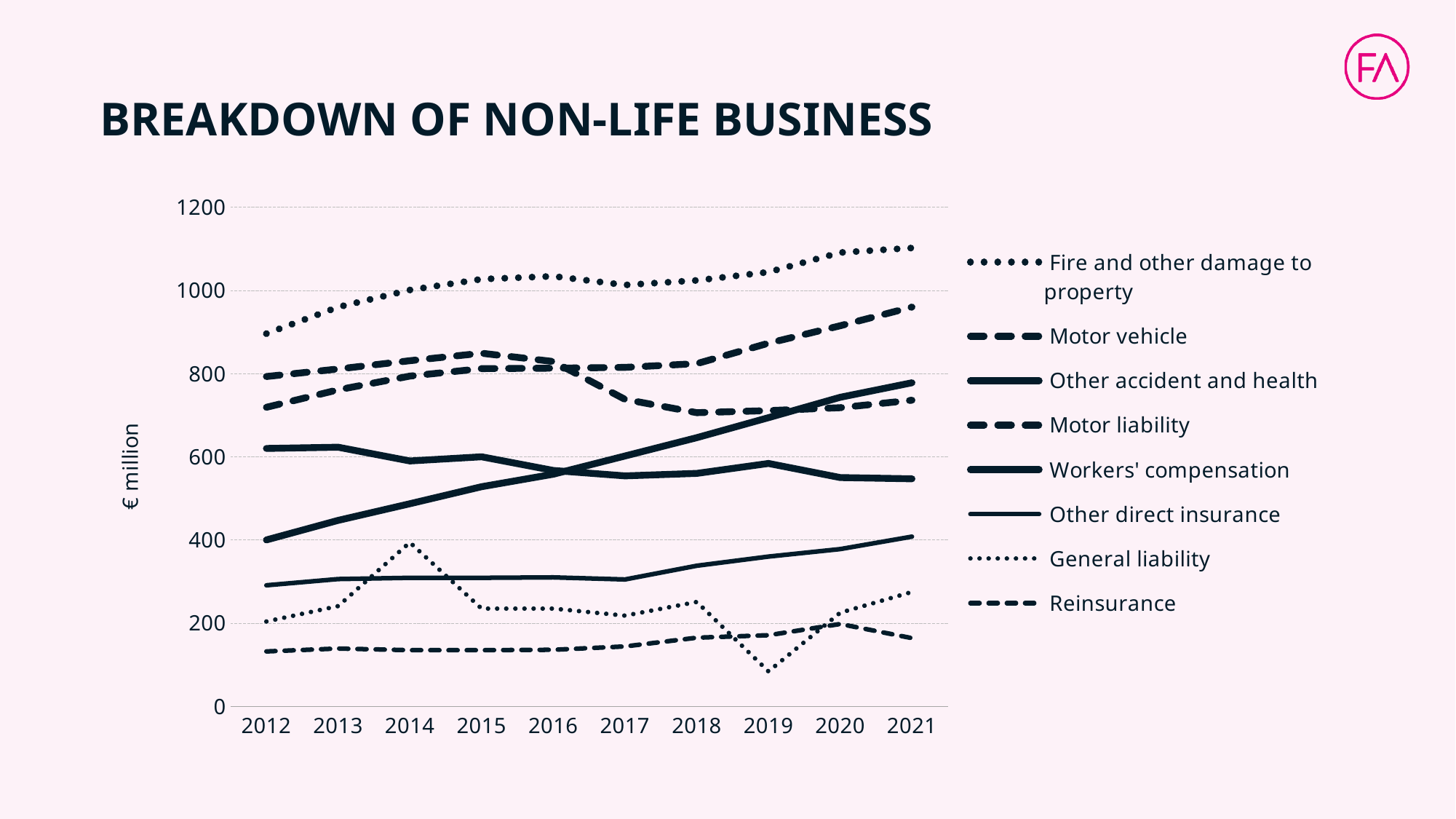
Is the value for Fire and other damage to property in 2012 greater or less than 1000? less How many series does the legend list? 8 In 2021, which is larger: Motor vehicle or Motor liability? Motor vehicle Is the value for Fire and other damage to property in 2021 greater or less than 1000? greater Is the value for General liability in 2019 greater or less than 200? less How many years are shown on the x axis? 10 What is the label on the y axis? € million What kind of chart is shown on the slide? Line chart Which series has the highest value in 2021? Fire and other damage to property Which series has the lowest value in 2021? Reinsurance Does the Other accident and health series rise or fall from 2012 to 2021? rise